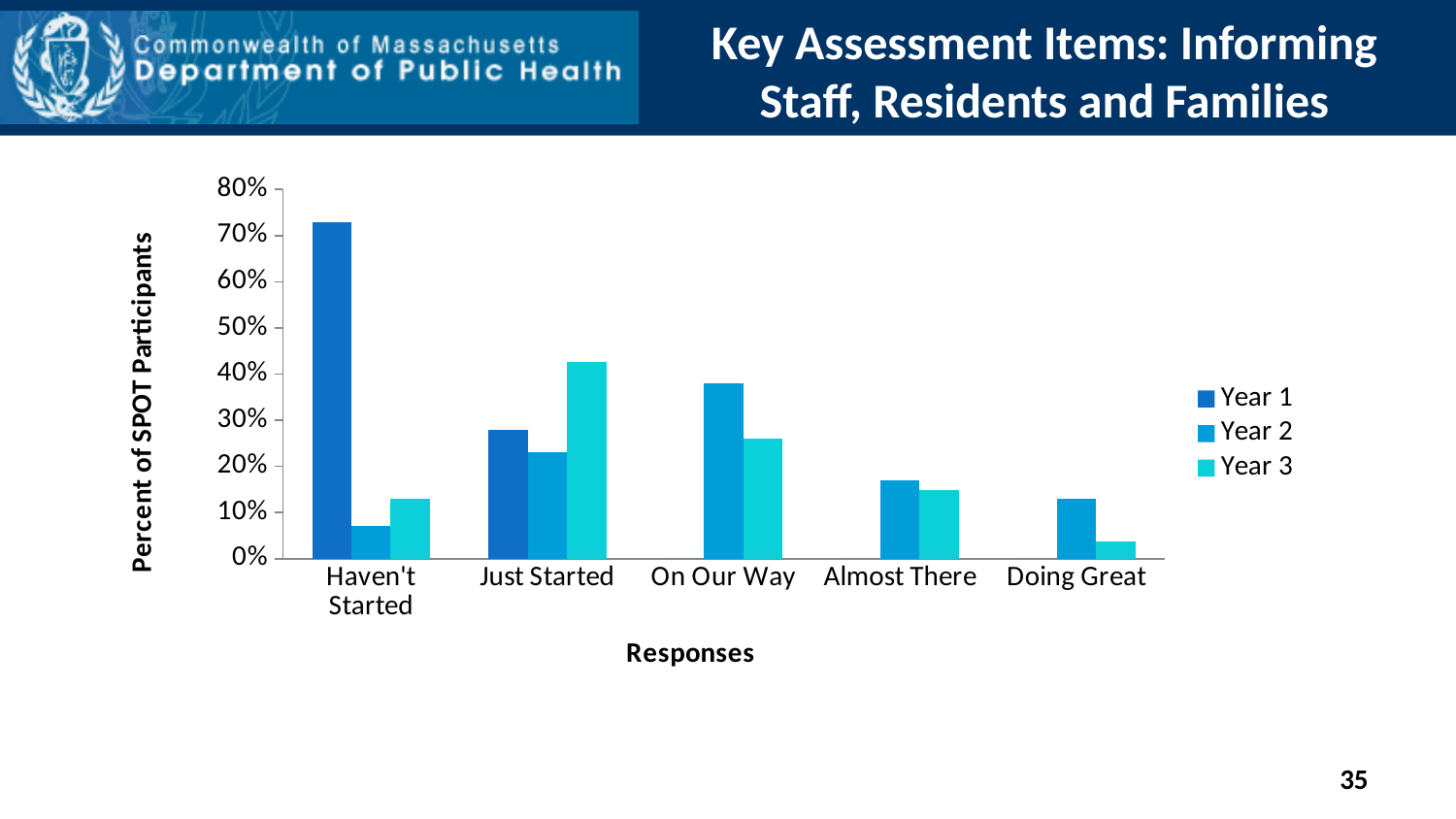
How many response categories are shown on the x axis? 5 Is the Year 1 value for Haven't Started greater or less than 70%? greater Which response category has the highest Year 3 value? Just Started Is the Year 3 value for Doing Great greater or less than 10%? less What is the title of the y axis? Percent of SPOT Participants How many series does the legend list? 3 Do the Year 2 values rise or fall from On Our Way to Doing Great? fall For On Our Way, which is larger: the Year 2 value or the Year 3 value? Year 2 Which response category has the highest Year 1 value? Haven't Started Is the Year 2 value for Haven't Started greater or less than 10%? less For Just Started, which is larger: the Year 1 value or the Year 3 value? Year 3 What kind of chart is shown on the slide? Bar chart